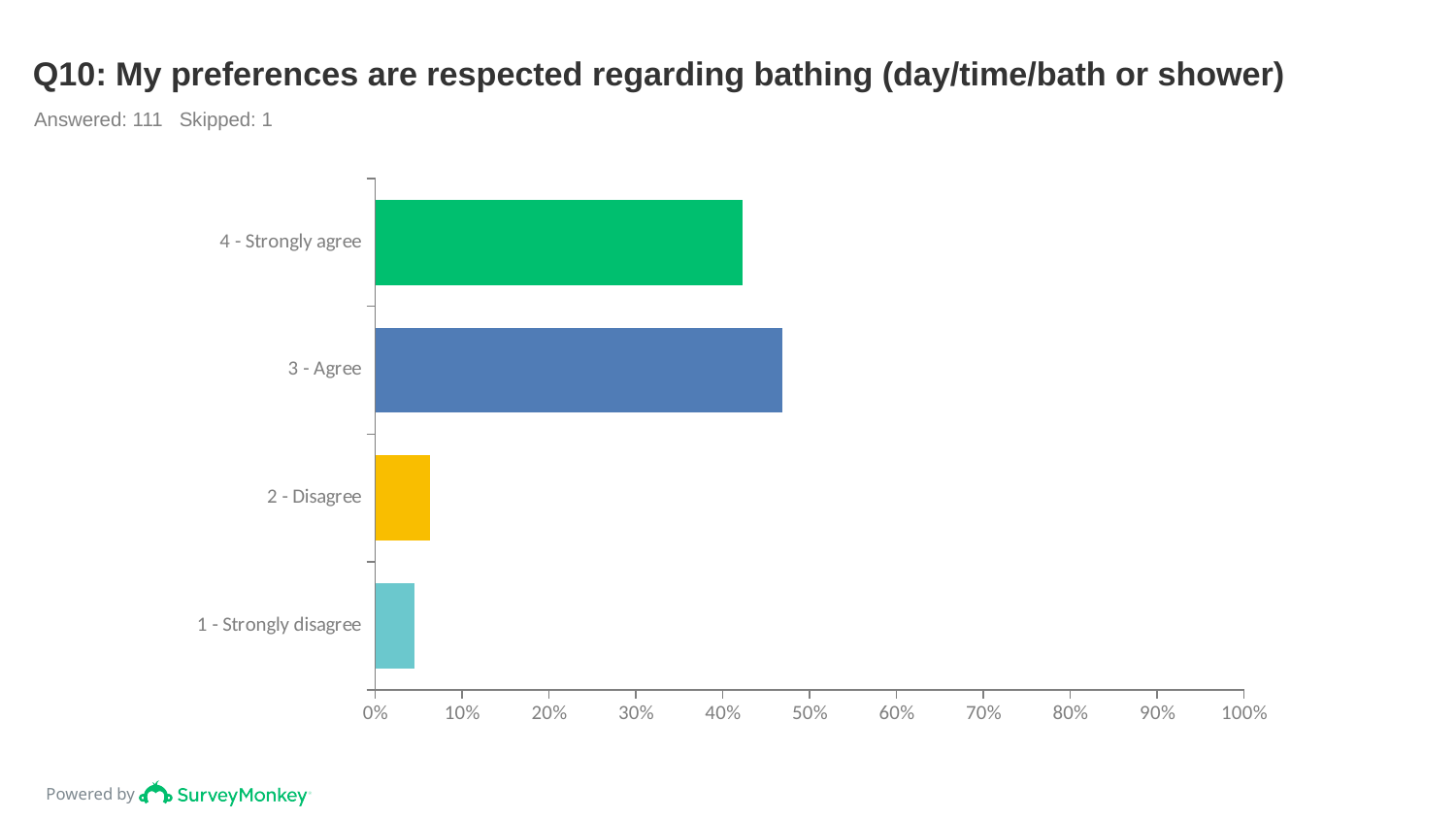
Is the value for 1 - Strongly disagree greater or less than 10%? less Is the value for 2 - Disagree greater or less than 10%? less How many response categories are shown in the chart? 4 Which is larger, the value for 3 - Agree or the value for 4 - Strongly agree? 3 - Agree Is the value for 4 - Strongly agree greater or less than 30%? greater Which response category has the lowest value? 1 - Strongly disagree How many respondents answered the question according to the slide? 111 Which response category has the highest value? 3 - Agree What kind of chart is shown on the slide? bar chart What is the title of the chart? Q10: My preferences are respected regarding bathing (day/time/bath or shower)